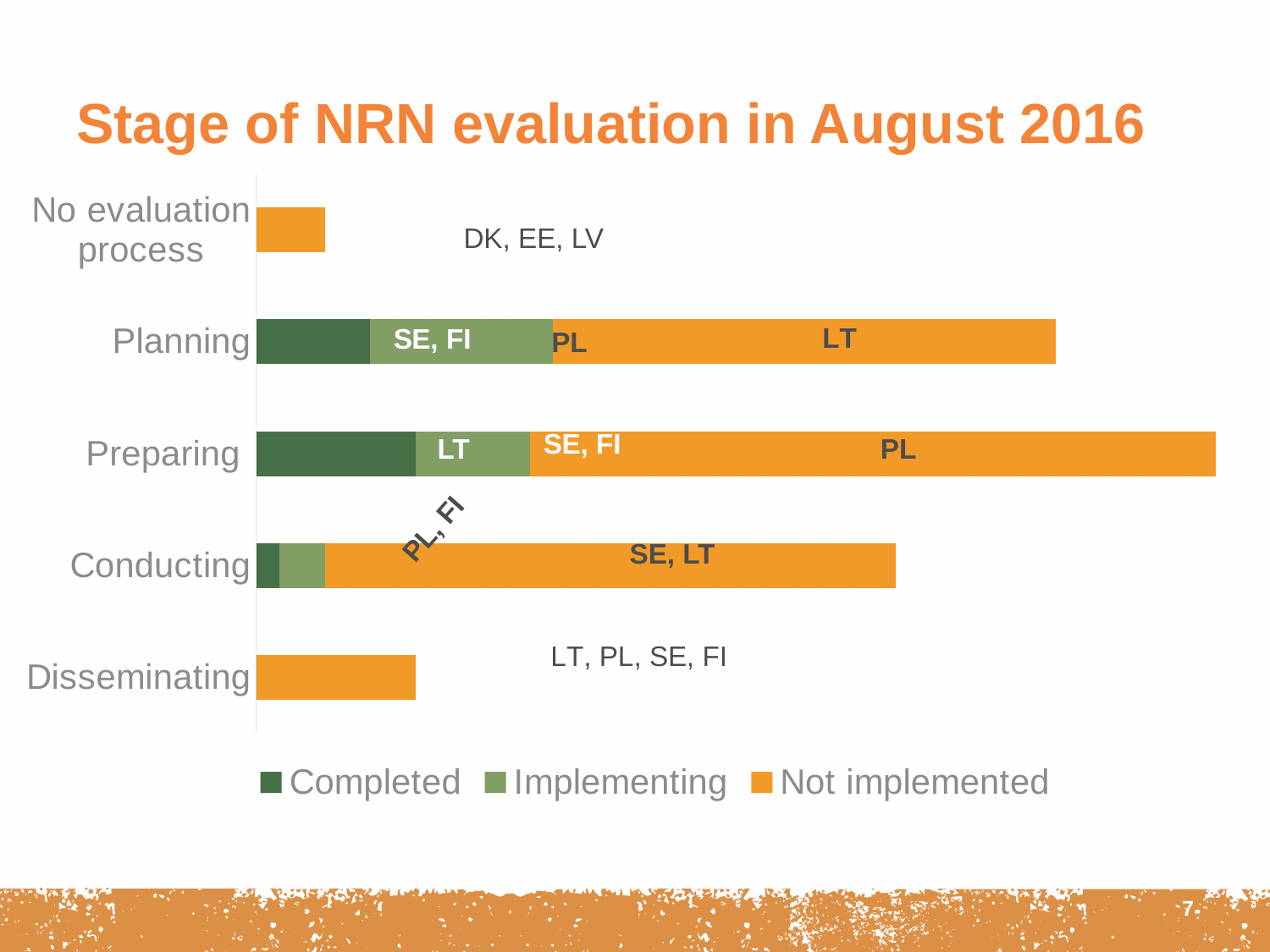
Which countries are labelled on the 'Not implemented' segment of the 'Conducting' bar? SE, LT Which category has the shortest total bar? No evaluation process Which total bar is longer, Planning or Conducting? Planning Which countries are listed next to the 'No evaluation process' bar? DK, EE, LV Which countries are listed next to the 'Disseminating' bar? LT, PL, SE, FI How many categories are shown on the vertical axis of the chart? 5 What kind of chart is shown on the slide? Bar chart How many series does the legend list? 3 How many categories consist only of a 'Not implemented' segment? 2 Which category has the longest total bar? Preparing Which colour represents the 'Not implemented' series in the legend? Orange What is the title of the chart? Stage of NRN evaluation in August 2016